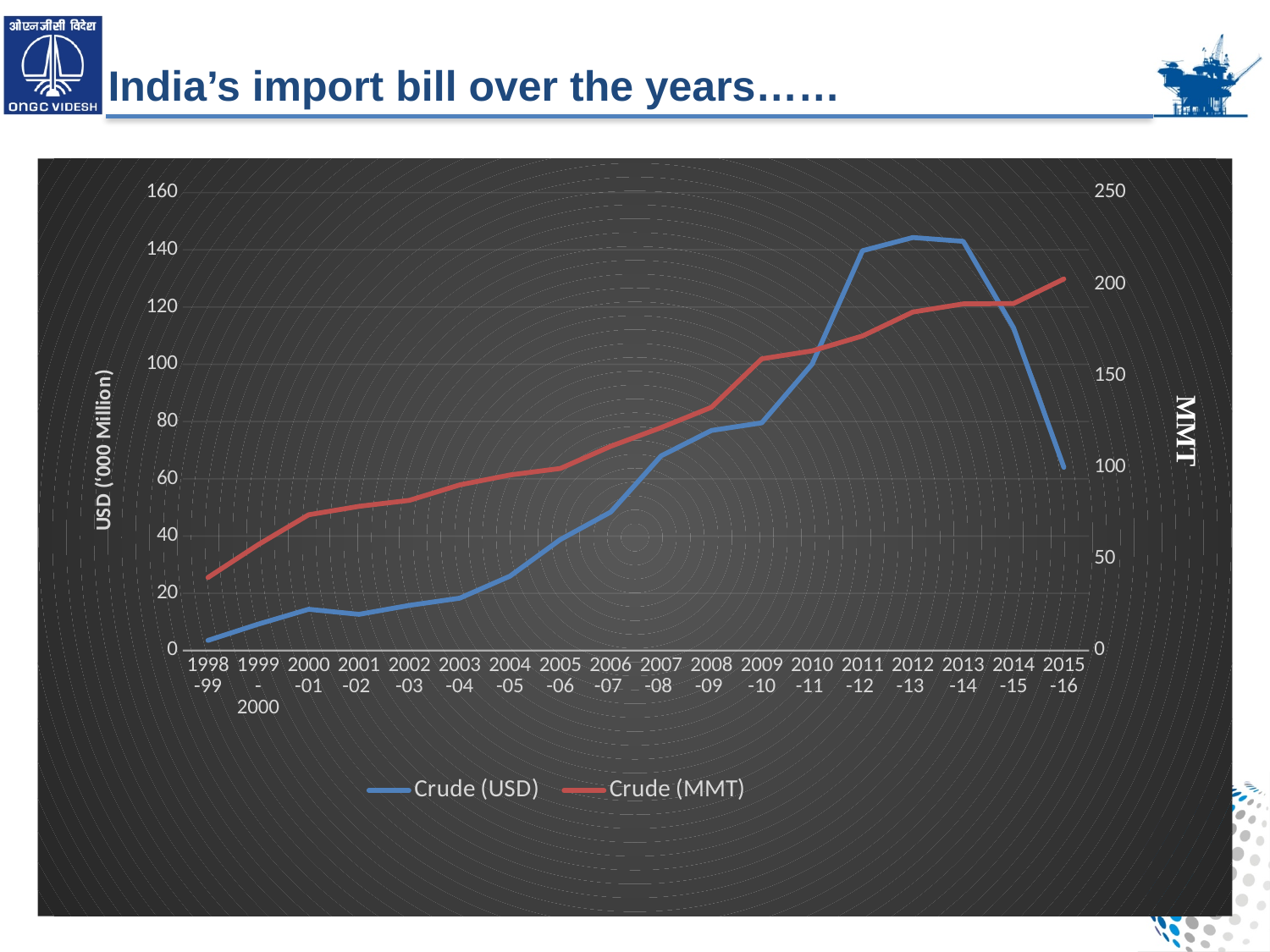
What kind of chart is shown on the slide? line chart Which year has the highest value for Crude (MMT)? 2015-16 Is the value for Crude (MMT) in 2015-16 greater or less than 150? greater Is the value for Crude (USD) in 2011-12 greater or less than 120? greater Does the Crude (USD) line rise or fall from 2013-14 to 2015-16? fall How many years are plotted along the x axis? 18 Is the value for Crude (MMT) in 1998-99 greater or less than 50? less Which year has the lowest value for Crude (USD)? 1998-99 Which year has the lowest value for Crude (MMT)? 1998-99 What is the title of the left vertical axis? USD ('000 Million) How many series does the legend list? 2